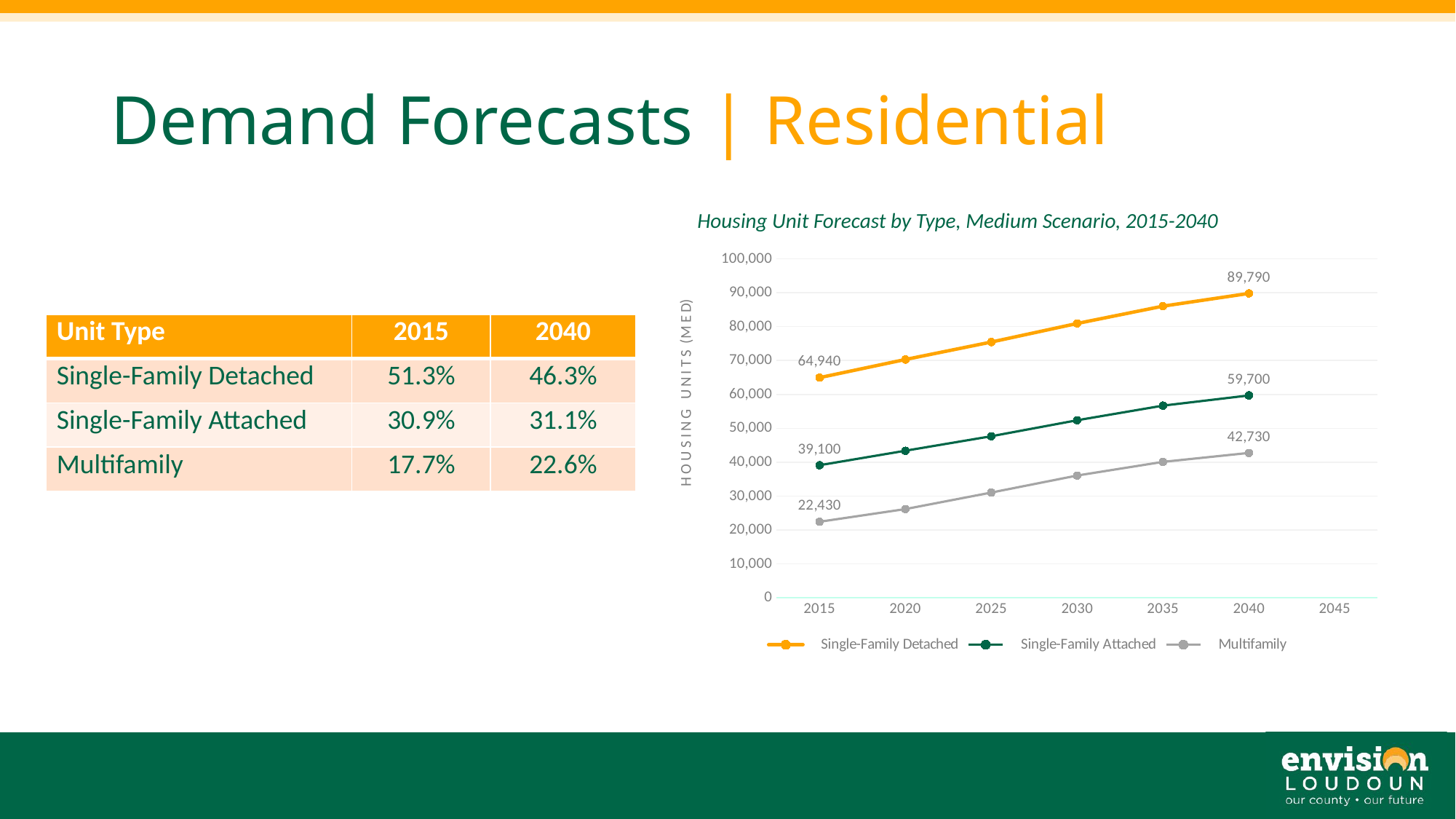
What is the value for Multifamily in 2040? 42,730 What is the difference between the Single-Family Detached values in 2040 and 2015? 24,850 What kind of chart is shown? line chart Is the value for Single-Family Attached in 2030 greater or less than 50,000? greater Which series has the highest value in 2040? Single-Family Detached How many series does the legend list? 3 What is the value for Single-Family Detached in 2015? 64,940 Which is larger in 2040, Single-Family Attached or Multifamily? Single-Family Attached What is the value for Single-Family Attached in 2015? 39,100 Do the Multifamily values rise or fall from 2015 to 2040? rise Which series has the lowest value in 2015? Multifamily What is the value for Single-Family Detached in 2040? 89,790